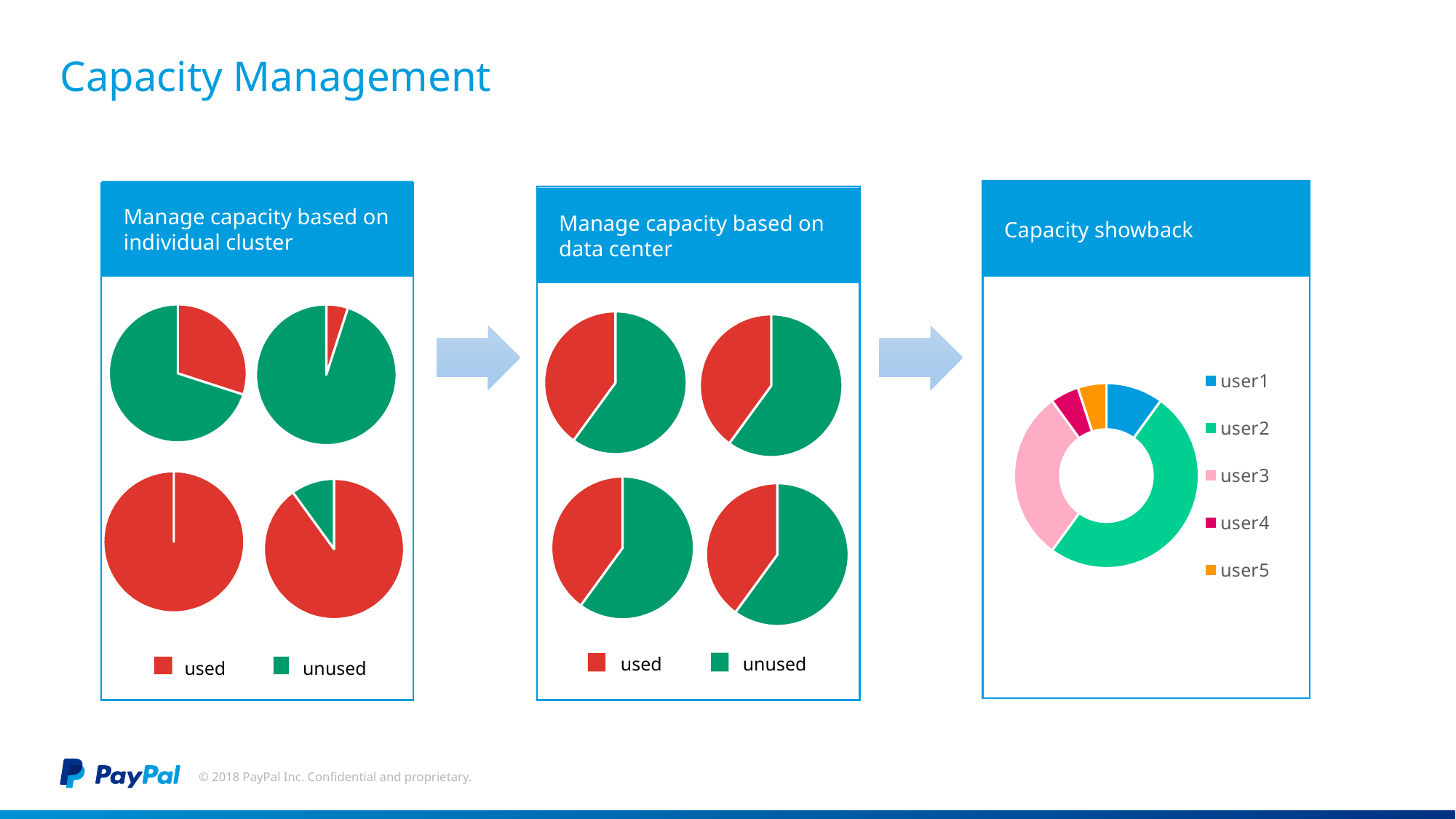
In the "Capacity showback" chart, which is larger, the share for user1 or the share for user2? user2 In the "Manage capacity based on data center" panel, what colour represents "used" in the legend? red In the "Capacity showback" chart, what kind of chart is shown? doughnut chart In the "Manage capacity based on individual cluster" panel, how many entries does the legend list? 2 In the "Manage capacity based on individual cluster" panel, in the bottom-left pie chart, which slice is larger, used or unused? used In the "Manage capacity based on individual cluster" panel, how many pie charts are shown? 4 In the "Manage capacity based on individual cluster" panel, in the top-right pie chart, which slice is larger, used or unused? unused In the "Capacity showback" chart, how many entries does the legend list? 5 In the "Manage capacity based on data center" panel, how many pie charts are shown? 4 In the "Capacity showback" chart, which user has the largest share? user2